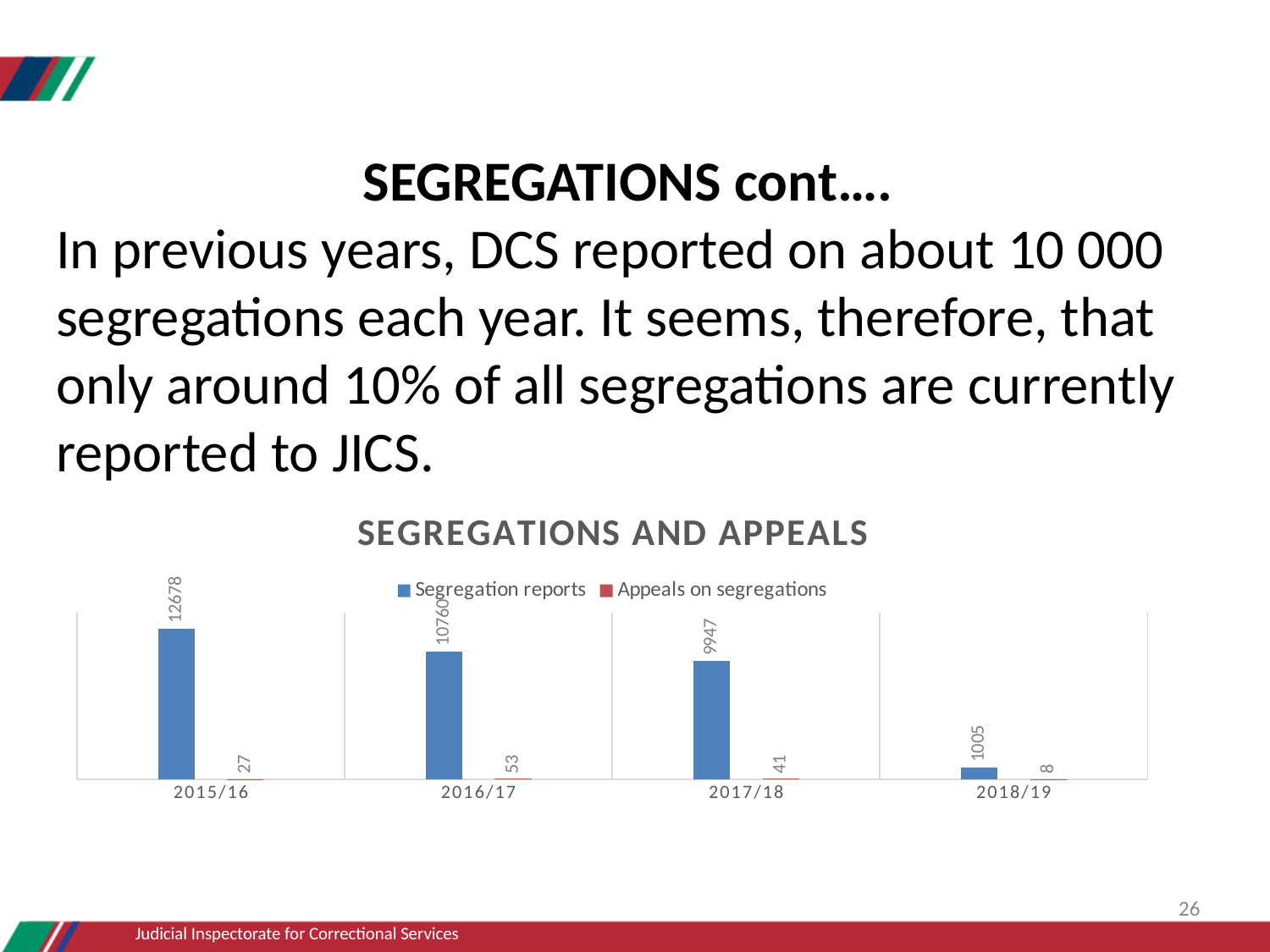
Which year has the highest value for Segregation reports? 2015/16 Do the Segregation reports values rise or fall from 2015/16 to 2018/19? Fall What is the value of Appeals on segregations for 2018/19? 8 How many series does the legend list? 2 What is the value of Appeals on segregations for 2016/17? 53 What kind of chart is shown? Bar chart Which is larger: Appeals on segregations in 2016/17 or in 2017/18? 2016/17 Which year has the lowest value for Appeals on segregations? 2018/19 What is the difference between Segregation reports in 2015/16 and 2016/17? 1918 What is the value of Segregation reports for 2015/16? 12678 How many years are shown on the x axis? 4 What is the value of Segregation reports for 2018/19? 1005